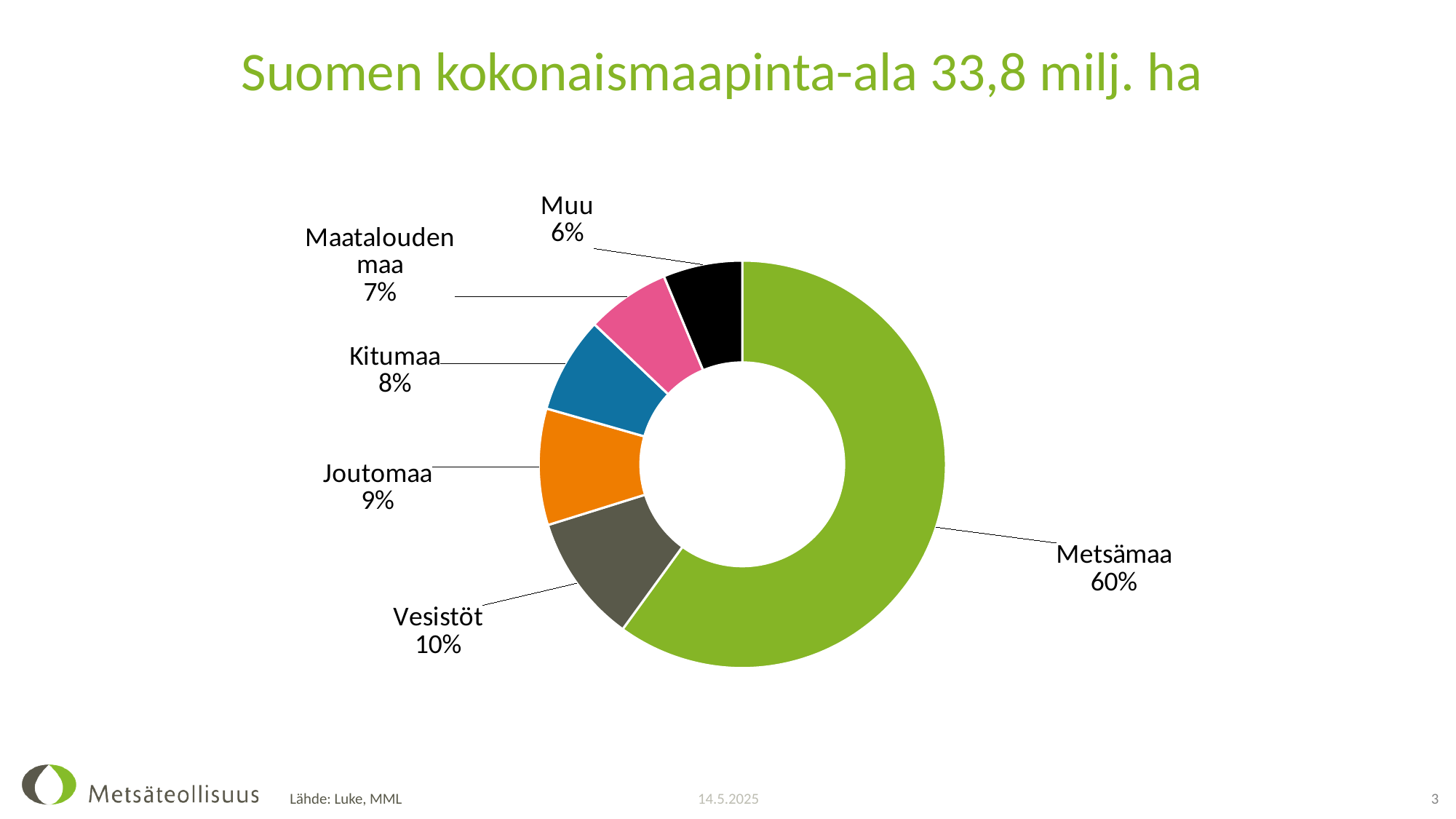
Which has a larger share, Joutomaa or Kitumaa? Joutomaa What percentage is shown for Kitumaa? 8% What percentage is shown for Joutomaa? 9% Which category has the largest share of the chart? Metsämaa What is the title of the slide? Suomen kokonaismaapinta-ala 33,8 milj. ha What percentage is shown for Maatalouden maa? 7% What kind of chart is shown on the slide? Pie chart (doughnut) What is the difference in percentage points between Metsämaa and Vesistöt? 50 What percentage is shown for Vesistöt? 10% What share of Finland's total land area is Metsämaa? 60% How many categories are shown in the chart? 6 Which category has the smallest share of the chart? Muu